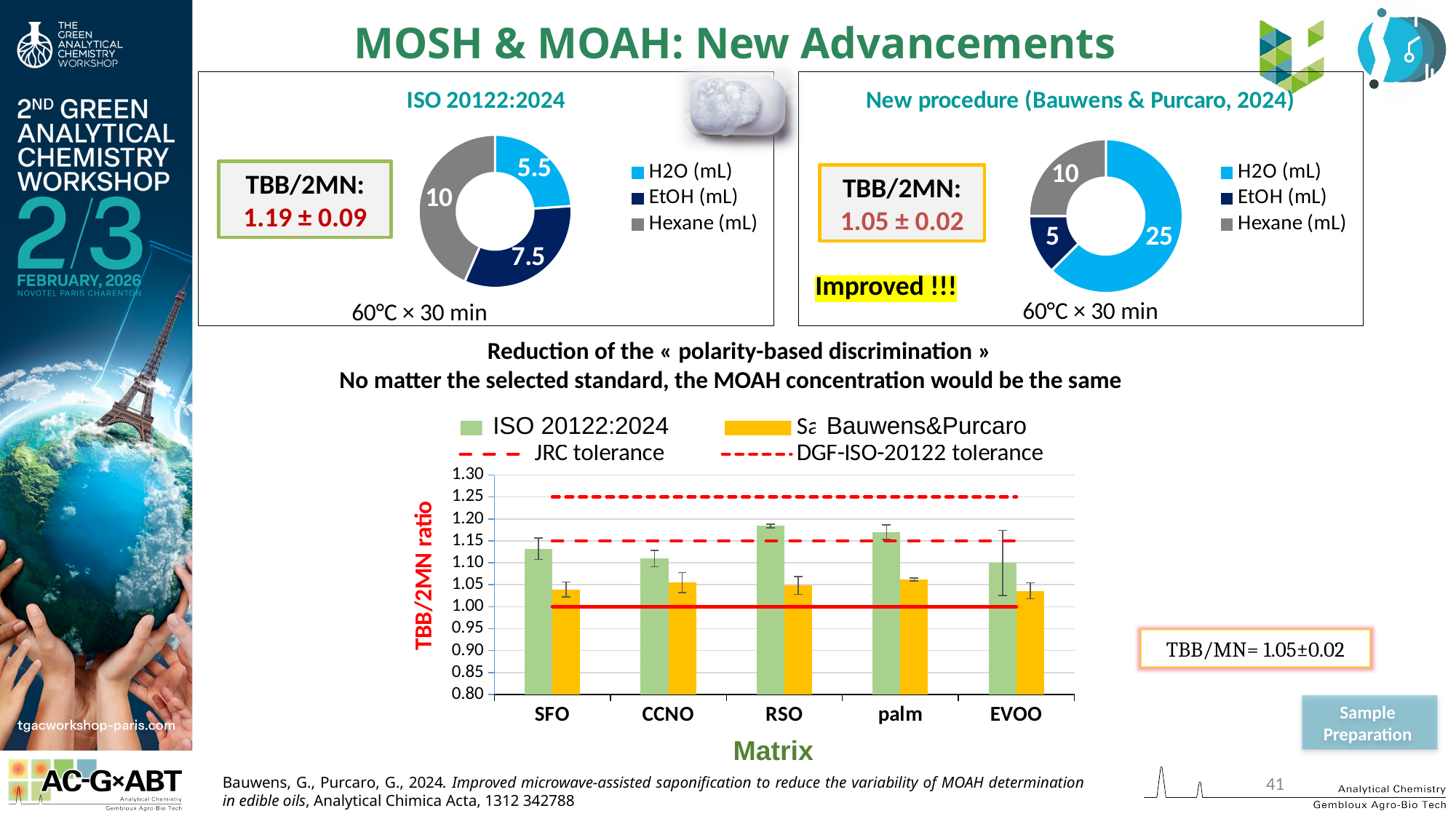
In the TBB/2MN ratio chart at the bottom, is the ISO 20122:2024 value for RSO greater or less than 1.15? greater In the ISO 20122:2024 donut chart, which solvent has the largest value? Hexane (mL) In the ISO 20122:2024 donut chart, what is the value for EtOH (mL)? 7.5 How many matrix categories are shown on the x axis of the TBB/2MN ratio chart at the bottom? 5 In the New procedure (Bauwens & Purcaro, 2024) donut chart, what is the value for H2O (mL)? 25 What kind of chart is the TBB/2MN ratio chart at the bottom of the slide? combination bar and line chart In the New procedure (Bauwens & Purcaro, 2024) donut chart, what share of the total does H2O represent? 62.5% In the TBB/2MN ratio chart at the bottom, which is larger for RSO: the ISO 20122:2024 bar or the Bauwens&Purcaro bar? ISO 20122:2024 In the New procedure (Bauwens & Purcaro, 2024) donut chart, which solvent has the smallest value? EtOH (mL) In the ISO 20122:2024 donut chart, what is the difference between the Hexane and H2O values? 4.5 In the New procedure (Bauwens & Purcaro, 2024) donut chart, what is the total of the three solvent volumes? 40 How many series does the legend of the TBB/2MN ratio chart at the bottom list? 4